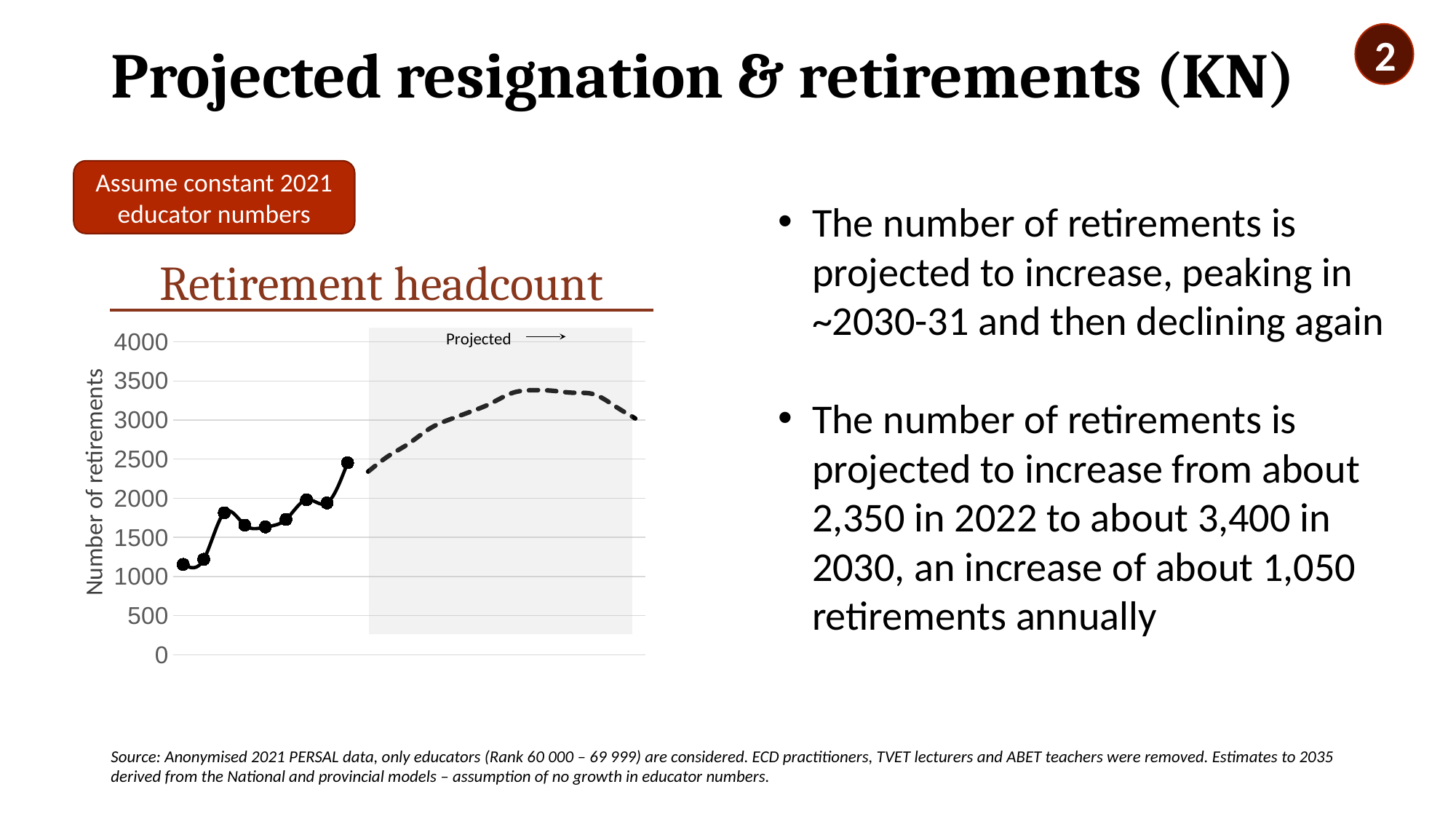
What is the highest tick value shown on the vertical axis of the Retirement headcount chart? 4000 In the Retirement headcount chart, does the solid (actual) line generally rise or fall from left to right? rise In the Retirement headcount chart, is the first plotted point of the solid line greater or less than 1500? less What is the title of the chart on the slide? Retirement headcount In the Retirement headcount chart, is the peak of the dashed (projected) line greater or less than 3500? less In the Retirement headcount chart, does the dashed (projected) line rise or fall after reaching its peak? fall In the Retirement headcount chart, is the peak of the dashed (projected) line greater or less than 3000? greater What kind of chart is the Retirement headcount chart? line chart What is the label on the vertical axis of the Retirement headcount chart? Number of retirements In the Retirement headcount chart, is the peak of the dashed (projected) line higher or lower than the highest point of the solid (actual) line? higher